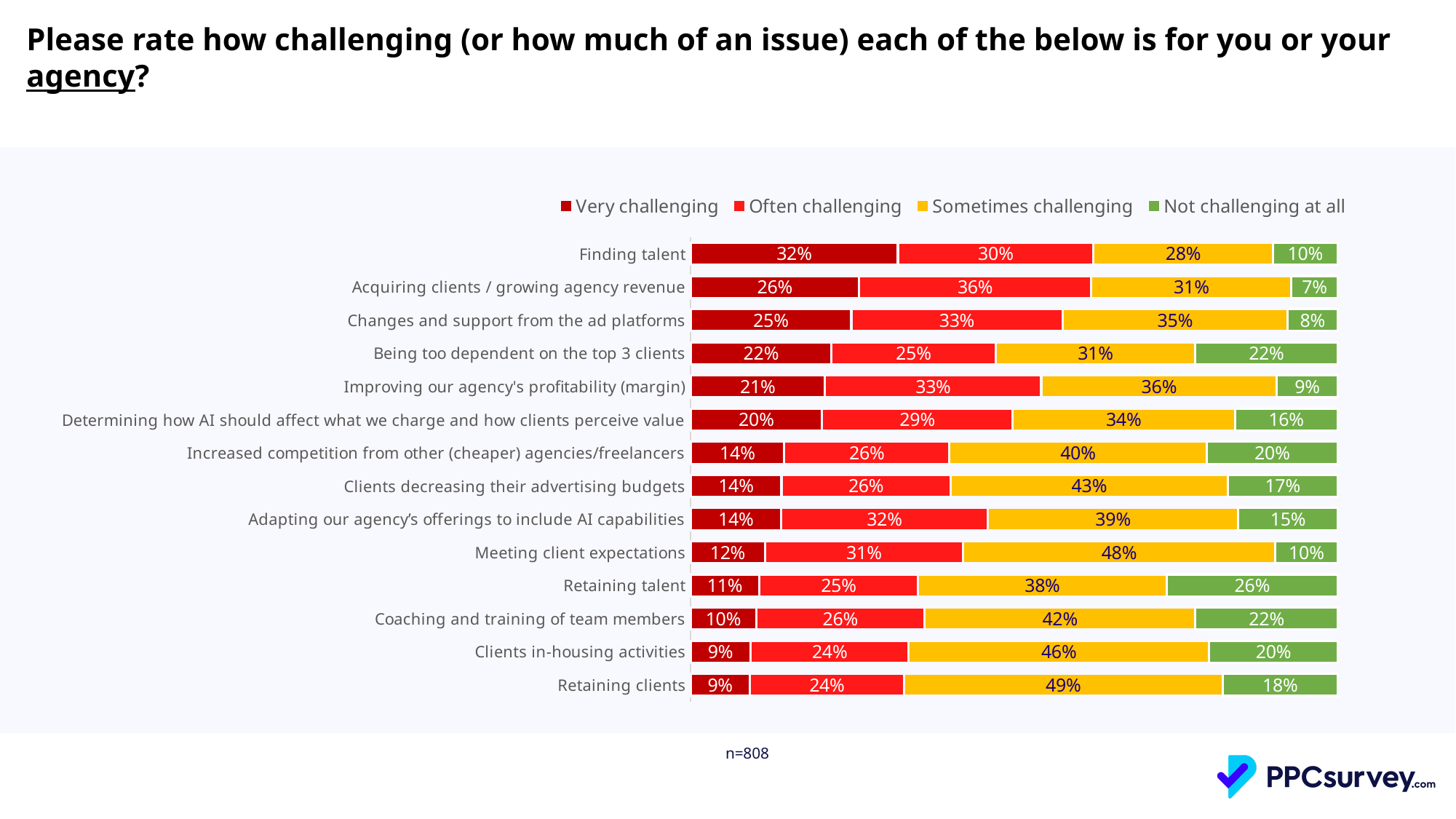
Which category has the lowest Not challenging at all percentage? Acquiring clients / growing agency revenue Which category has the highest Very challenging percentage? Finding talent How many series does the legend list? 4 What percentage rated "Retaining talent" as Not challenging at all? 26% What percentage rated "Meeting client expectations" as Sometimes challenging? 48% What is the sample size noted below the chart? n=808 Which category has the highest Sometimes challenging percentage? Retaining clients What is the difference between the Often challenging percentages for "Acquiring clients / growing agency revenue" and "Finding talent"? 6% How many categories are shown in the chart? 14 What kind of chart is shown on the slide? Stacked bar chart Which has a larger Very challenging percentage: "Being too dependent on the top 3 clients" or "Meeting client expectations"? Being too dependent on the top 3 clients What percentage of respondents rated "Finding talent" as Very challenging? 32%